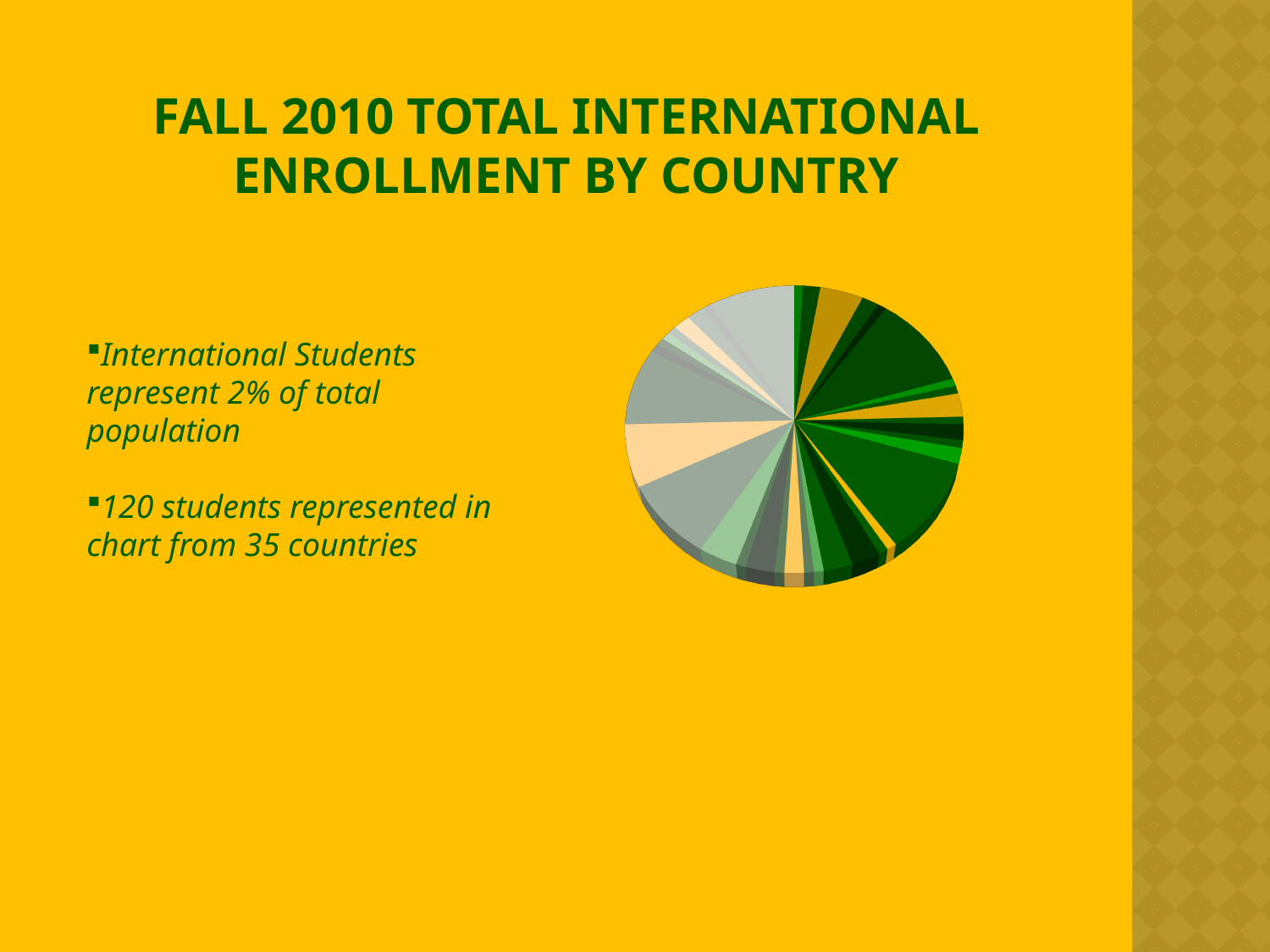
Does the pie chart display a legend or data labels for its slices? No According to the slide text, how many countries are represented in the pie chart? 35 According to the slide text, how many students are represented in the pie chart? 120 What is the title of the slide containing the pie chart? Fall 2010 Total International Enrollment by Country What kind of chart is shown on the slide? pie chart